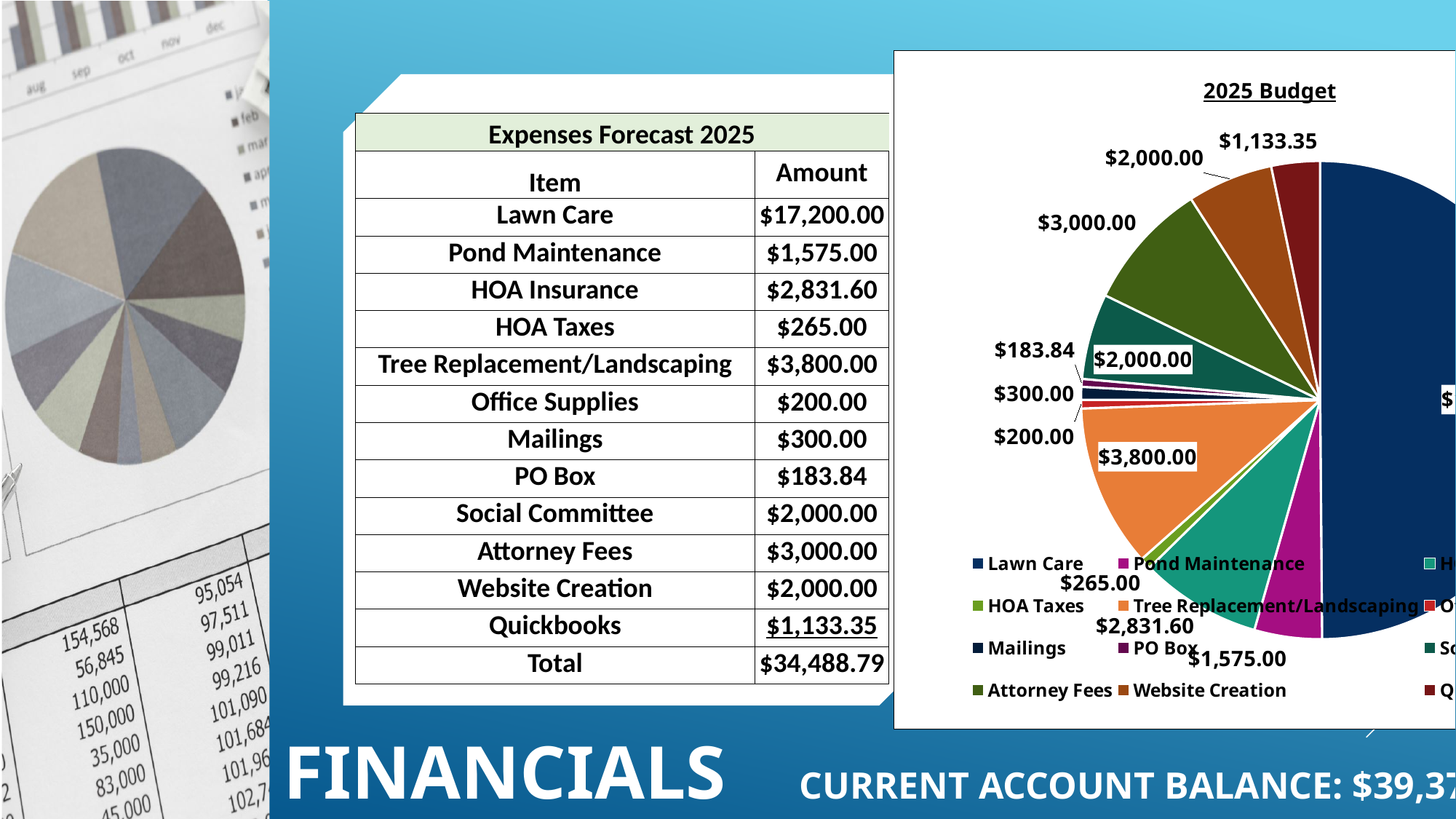
In the "2025 Budget" pie chart, what is the value for Pond Maintenance? $1,575.00 In the "2025 Budget" pie chart, what is the difference between Tree Replacement/Landscaping and Attorney Fees? $800.00 In the "2025 Budget" pie chart, which is larger: Tree Replacement/Landscaping or Pond Maintenance? Tree Replacement/Landscaping Which category has the largest slice in the "2025 Budget" pie chart? Lawn Care What kind of chart is the "2025 Budget" chart? pie chart In the "2025 Budget" pie chart, what is the value for HOA Taxes? $265.00 In the "2025 Budget" pie chart, what is the value for Tree Replacement/Landscaping? $3,800.00 In the "2025 Budget" pie chart, what is the value for Attorney Fees? $3,000.00 How many categories are plotted in the "2025 Budget" pie chart? 12 In the "2025 Budget" pie chart, what is the value for PO Box? $183.84 What is the title of the pie chart on the slide? 2025 Budget In the "2025 Budget" pie chart, which is larger: Attorney Fees or Website Creation? Attorney Fees